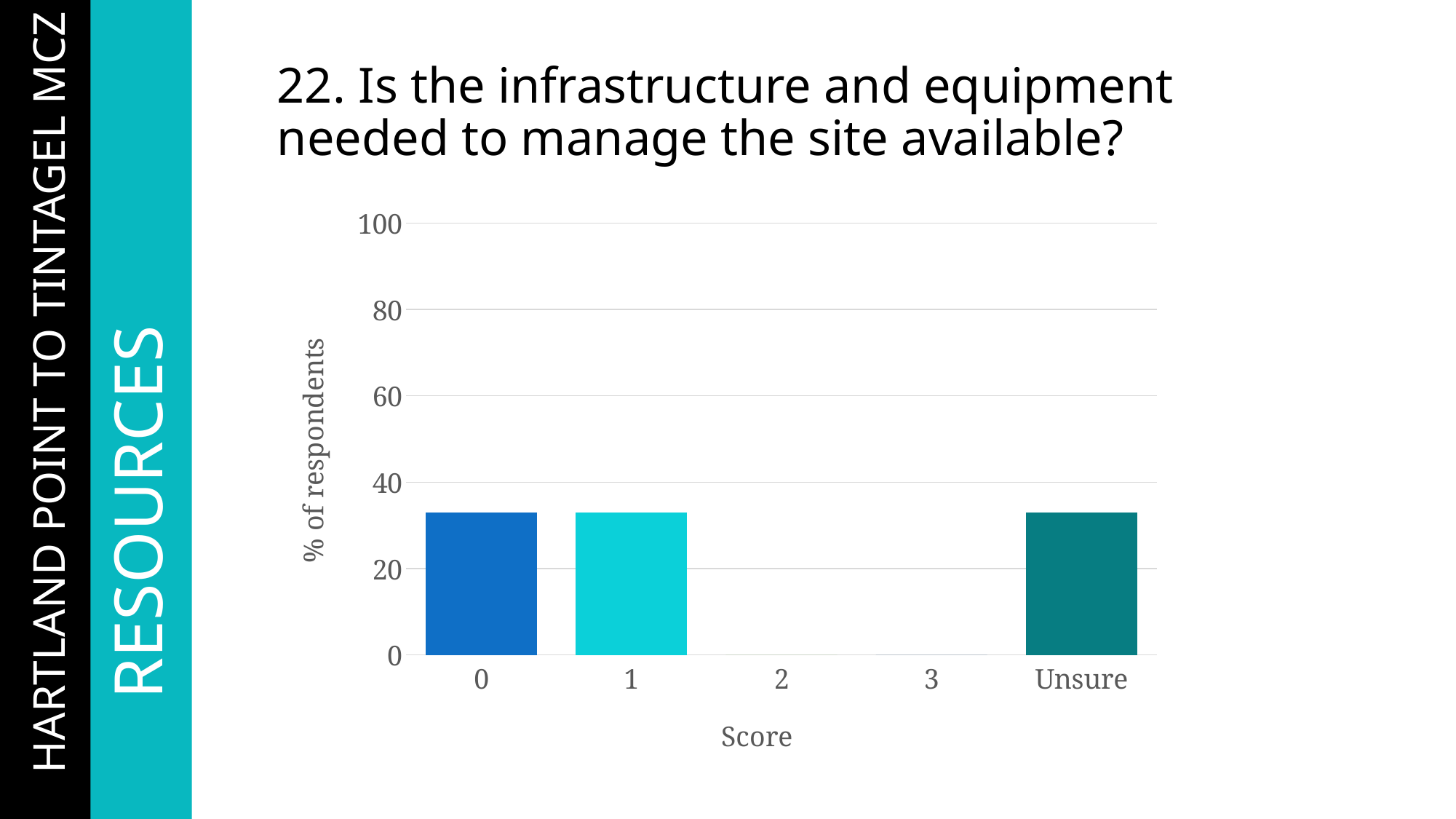
What is the label of the y axis? % of respondents How many categories are shown on the x axis of the chart? 5 Is the value for score 1 greater or less than 40? less Is the value for score 0 greater or less than 40? less Which is larger, the value for score 0 or the value for score 2? score 0 Is the value for Unsure greater or less than 20? greater Which is larger, the value for score 3 or the value for Unsure? Unsure What kind of chart is shown on the slide? bar chart What is the value for score 2? 0 What is the label of the x axis? Score What is the value for score 3? 0